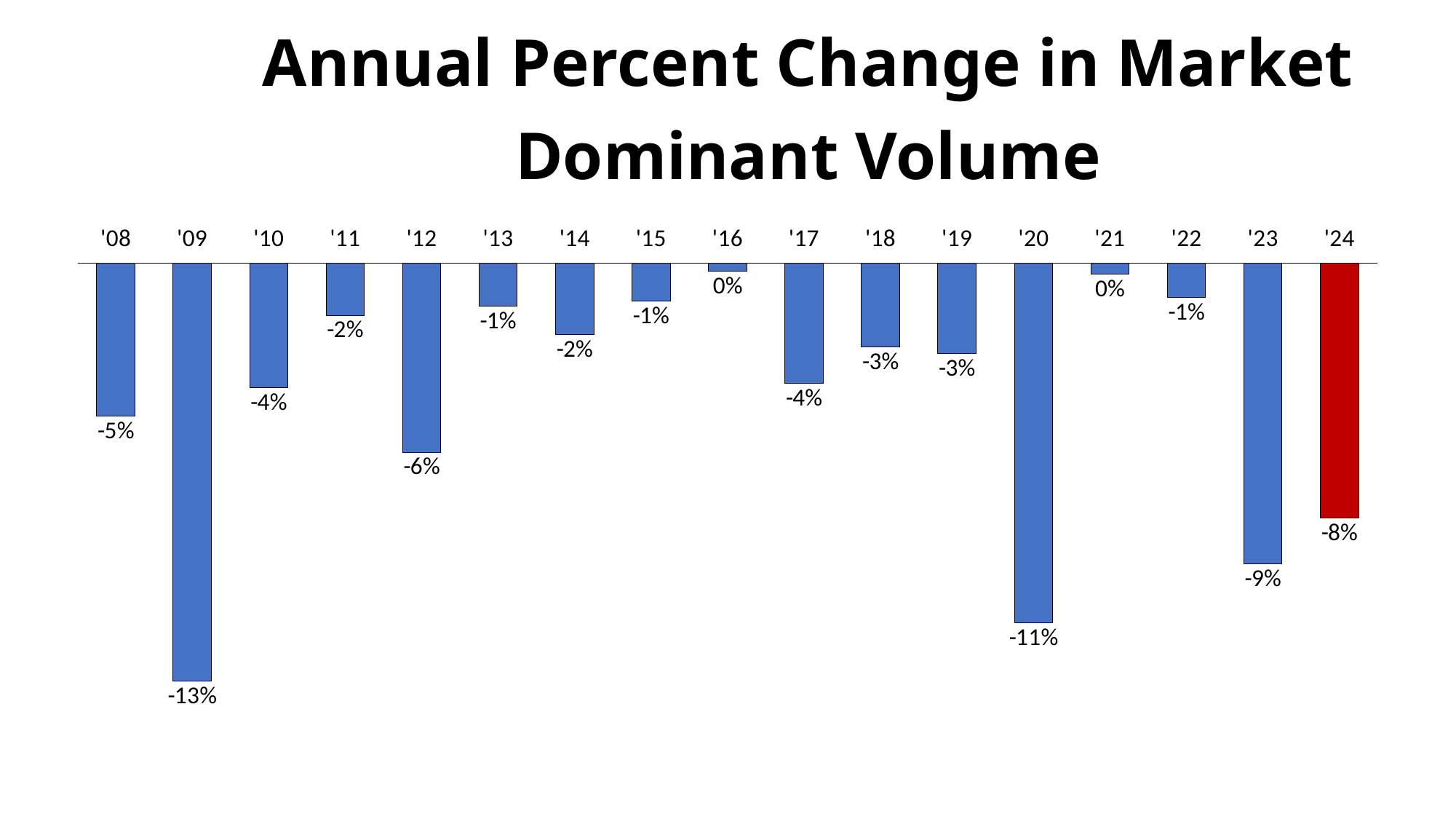
What is the value for '12? -6% What is the title of the chart? Annual Percent Change in Market Dominant Volume How many years are shown on the chart? 17 What is the difference between the values for '20 and '23? 2 percentage points What is the value for '09? -13% What is the difference between the values for '09 and '24? 5 percentage points What is the value for '20? -11% Which year has the lowest value? '09 Which is larger, the value for '12 or the value for '17? '17 What is the value for '24? -8% Which year's bar is coloured red? '24 What kind of chart is this? Bar chart